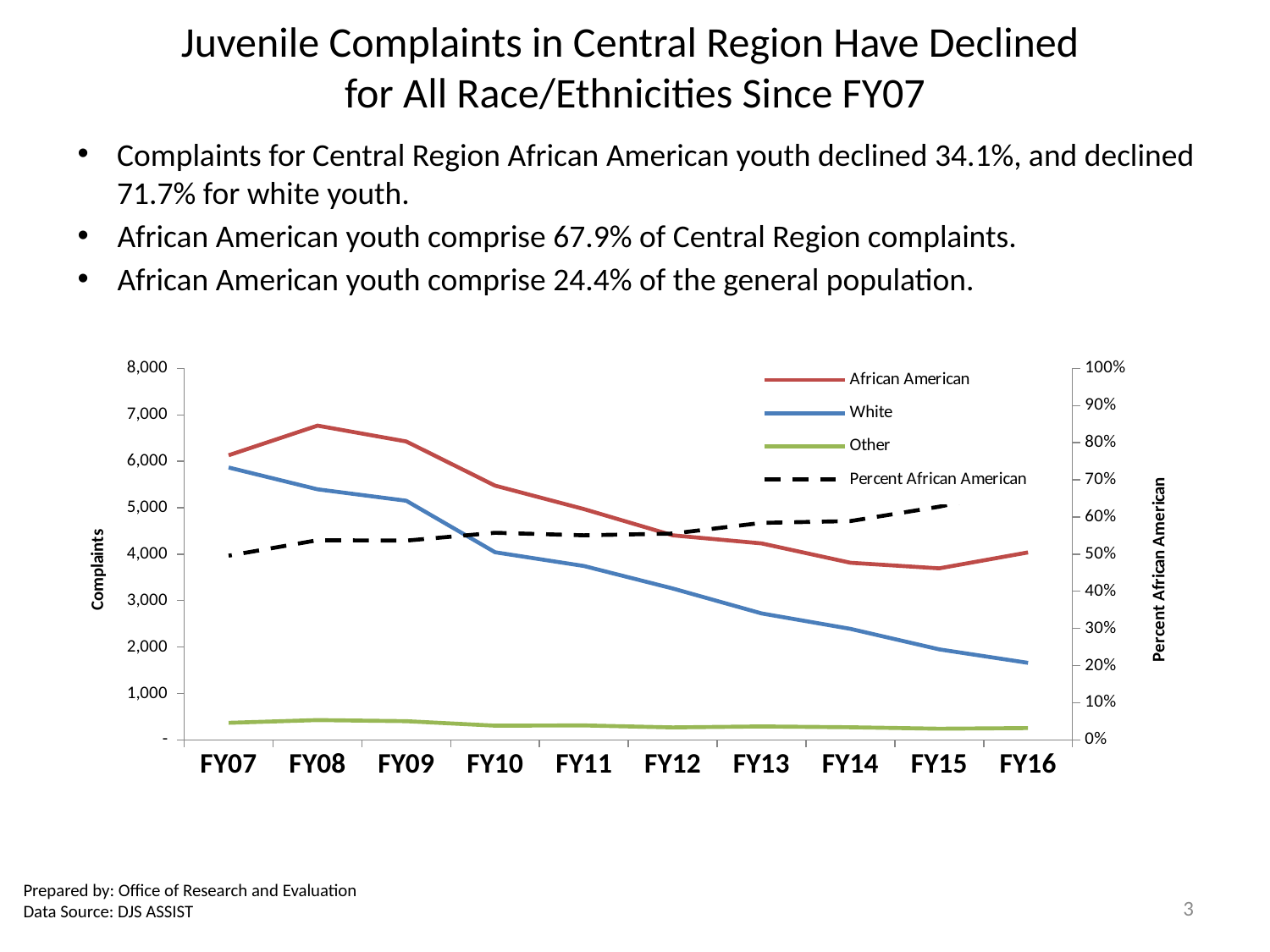
Is the value for White complaints in FY16 greater or less than 2,000? less Is the value for African American complaints in FY16 greater or less than 5,000? less Is the value for White complaints in FY07 greater or less than 5,000? greater In FY10, which series has more complaints, African American or White? African American How many series does the chart legend list? 4 What kind of chart is shown on the slide? line chart Do White complaints rise or fall from FY07 to FY16? fall In which fiscal year is the African American complaints line at its highest? FY08 How many fiscal years are shown on the x axis of the chart? 10 In which fiscal year is the White complaints line at its lowest? FY16 Which series in the chart is drawn as a dashed line? Percent African American